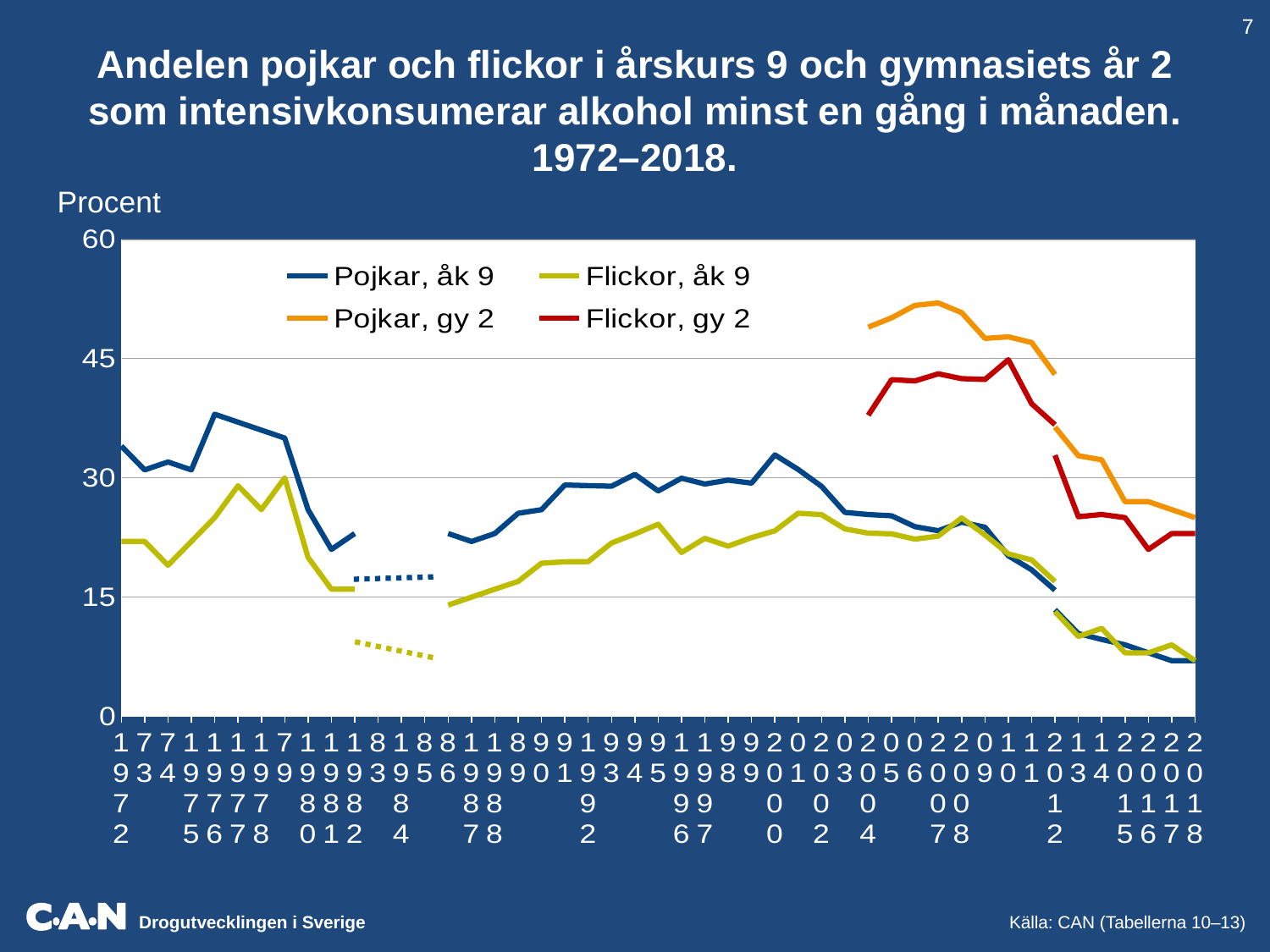
Is the value for Pojkar, åk 9 in 1977 greater or less than 30? greater What are the four series named in the legend? Pojkar, åk 9; Flickor, åk 9; Pojkar, gy 2; Flickor, gy 2 What kind of chart is shown on the slide? line chart In 2004, which is higher: Pojkar, gy 2 or Flickor, gy 2? Pojkar, gy 2 Which series reaches the highest value anywhere on the chart? Pojkar, gy 2 Is the value for Flickor, gy 2 in 2018 greater or less than 15? greater What label is shown above the vertical axis? Procent Is the peak value of the Pojkar, gy 2 series greater or less than 45? greater Does the Pojkar, gy 2 series rise or fall from 2007 to 2018? fall How many series does the legend list? 4 Does the Pojkar, åk 9 series rise or fall from 2000 to 2018? fall